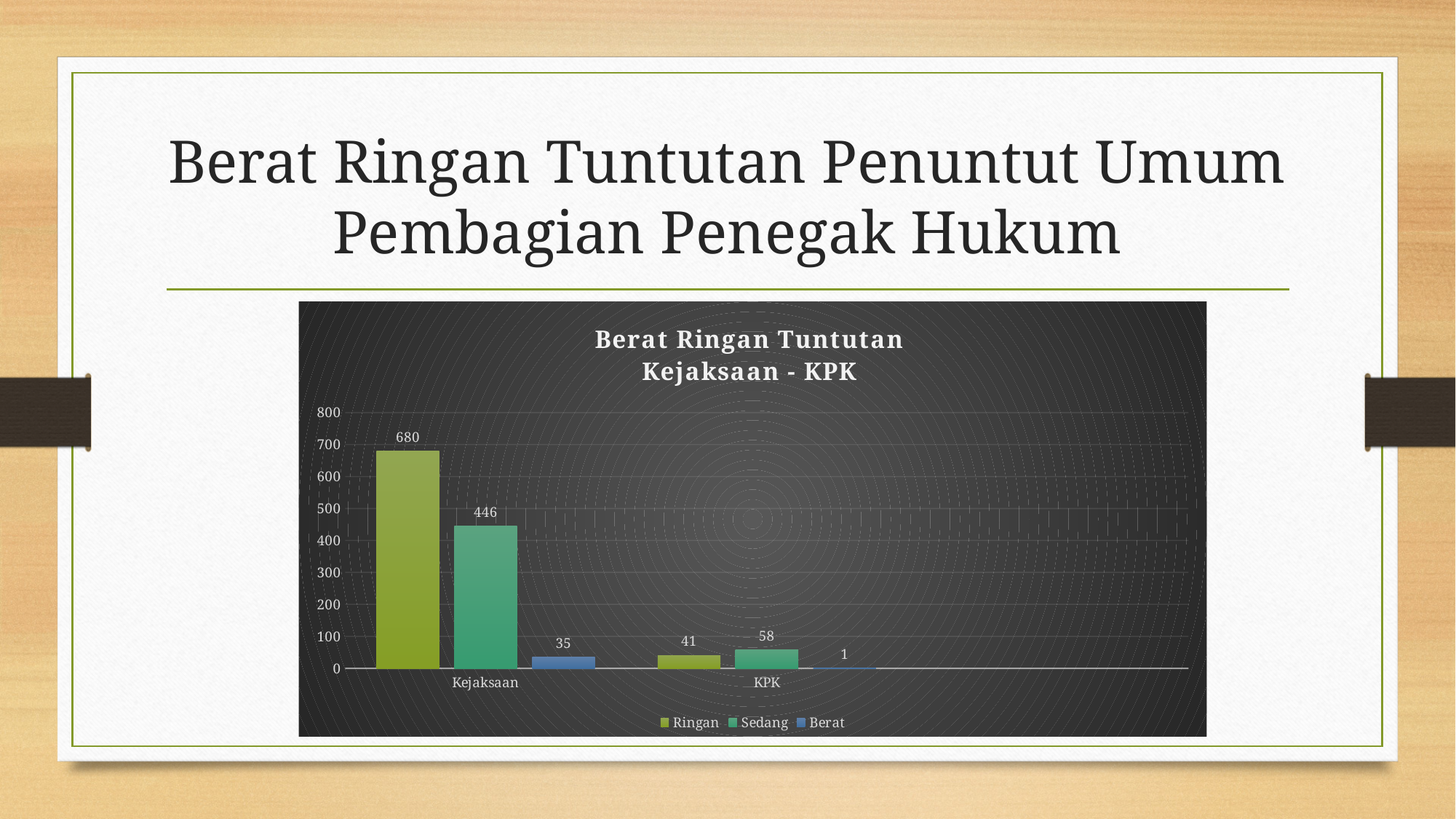
What is the value for Ringan in the Kejaksaan category? 680 What is the title of the chart? Berat Ringan Tuntutan Kejaksaan - KPK Which series has the highest value in the Kejaksaan category? Ringan Which is larger for KPK, Ringan or Sedang? Sedang What is the value for Sedang in the KPK category? 58 How many series does the legend list? 3 Which series has the lowest value in the KPK category? Berat What is the value for Berat in the Kejaksaan category? 35 What is the difference between the Ringan and Sedang values for Kejaksaan? 234 Is the value for Sedang in the Kejaksaan category greater or less than 400? greater What kind of chart is shown on the slide? Bar chart How many categories are shown on the x axis? 2